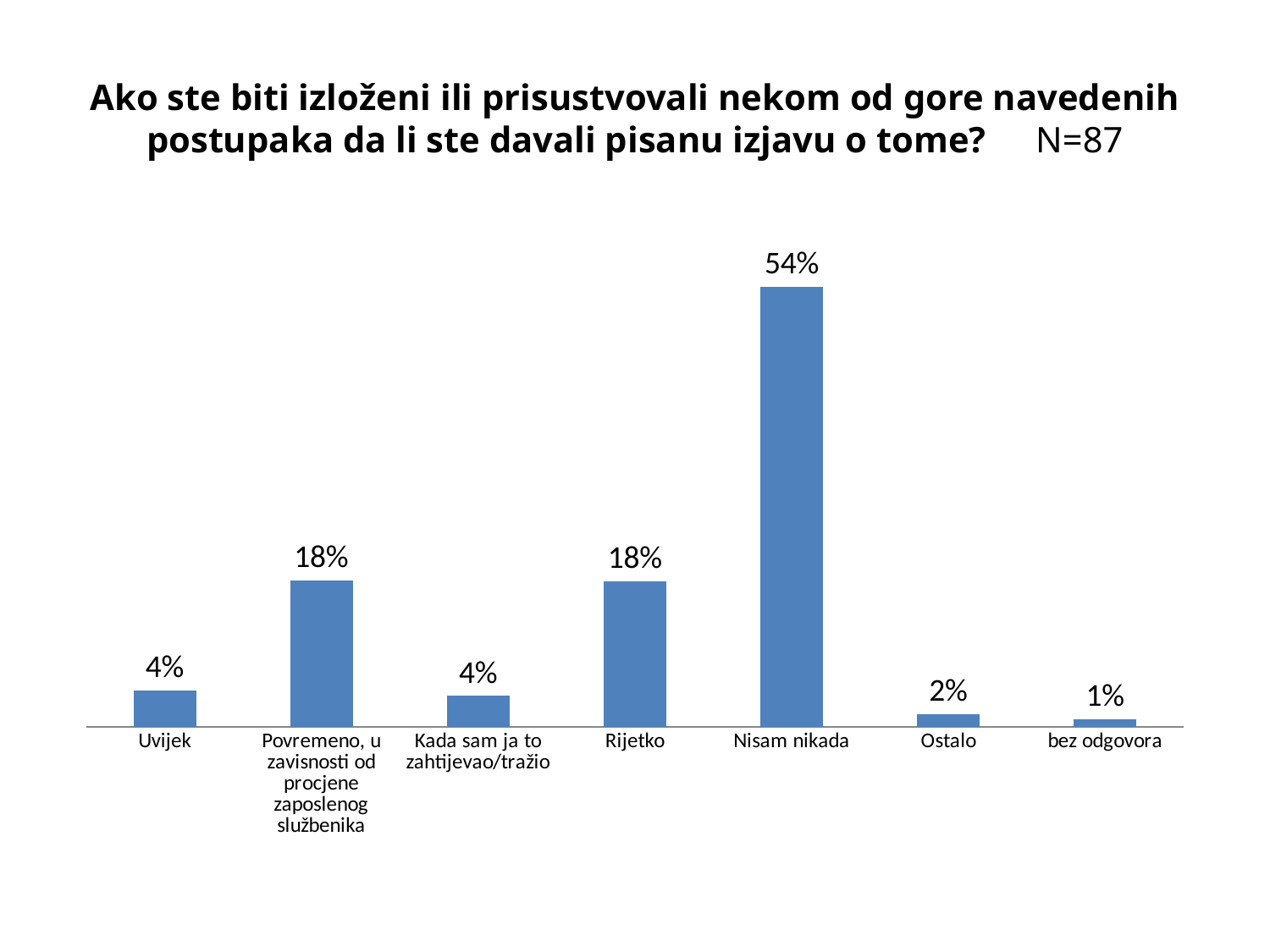
What is the value for "Ostalo"? 2% What is the value for "bez odgovora"? 1% How many categories are shown on the x axis? 7 What is the difference between the values for "Nisam nikada" and "Rijetko"? 36% Which category has the lowest value? bez odgovora What is the value for "Rijetko"? 18% What is the value for "Nisam nikada"? 54% Which category has the highest value? Nisam nikada What sample size (N) is stated in the chart title? N=87 Which is larger, the value for "Uvijek" or the value for "Ostalo"? Uvijek What is the difference between the values for "Povremeno, u zavisnosti od procjene zaposlenog službenika" and "Kada sam ja to zahtijevao/tražio"? 14% What kind of chart is shown on the slide? Bar chart